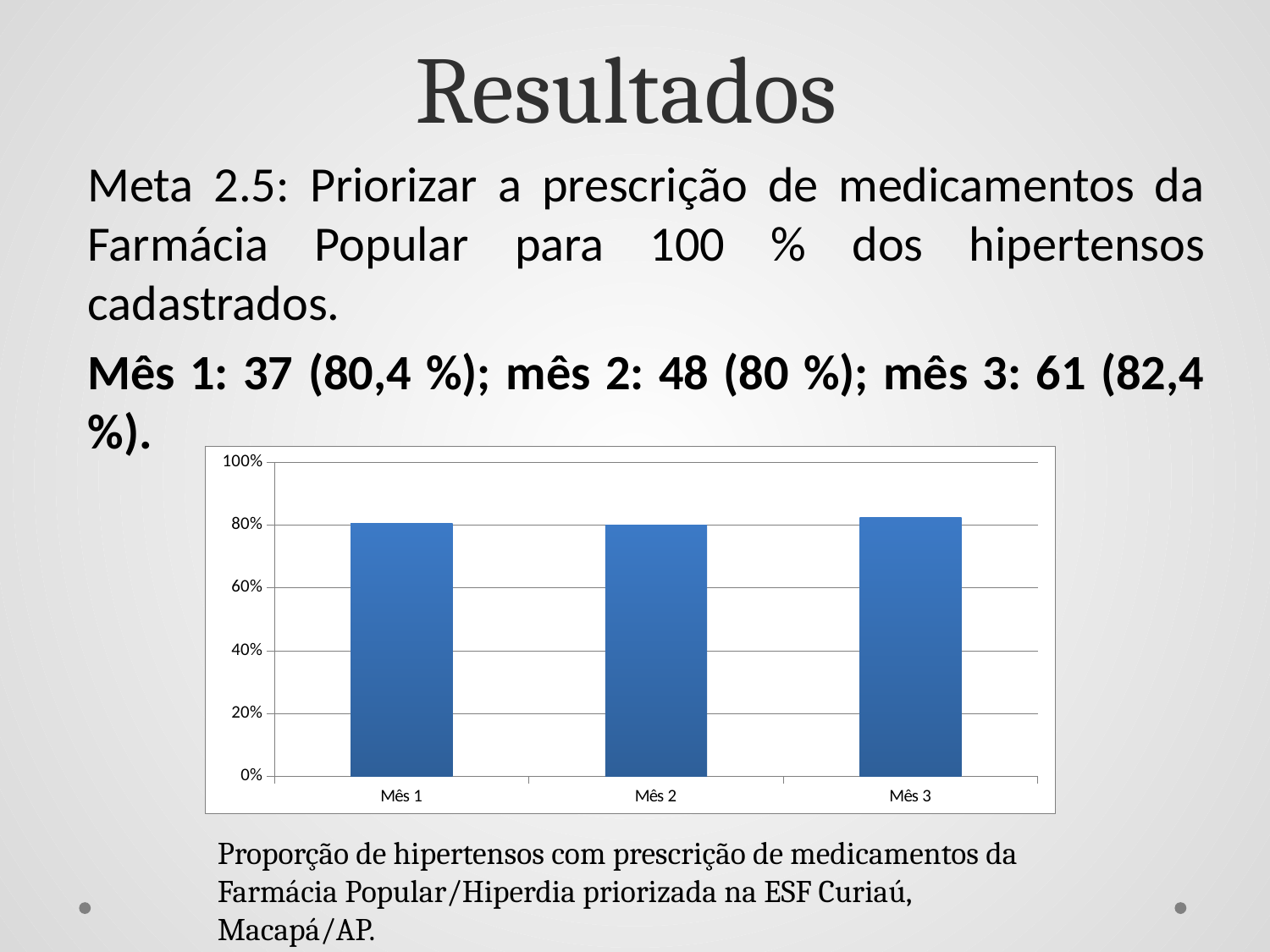
How many categories (months) are plotted in the chart? 3 Is the value for Mês 3 greater or less than 100%? less According to the slide text, what proportion of hypertensive patients had Farmácia Popular prescriptions in mês 3? 82,4 % What is the highest value shown on the chart's vertical axis? 100% Is the value for Mês 2 greater or less than 60%? greater Is the value for Mês 1 greater or less than 40%? greater What are the category labels along the x axis of the chart? Mês 1, Mês 2, Mês 3 Which bar is taller, Mês 3 or Mês 1? Mês 3 What kind of chart is shown on the slide? bar chart According to the slide text, what proportion is reported for mês 1? 80,4 % According to the slide text, what proportion is reported for mês 2? 80 % Which month has the highest bar in the chart? Mês 3